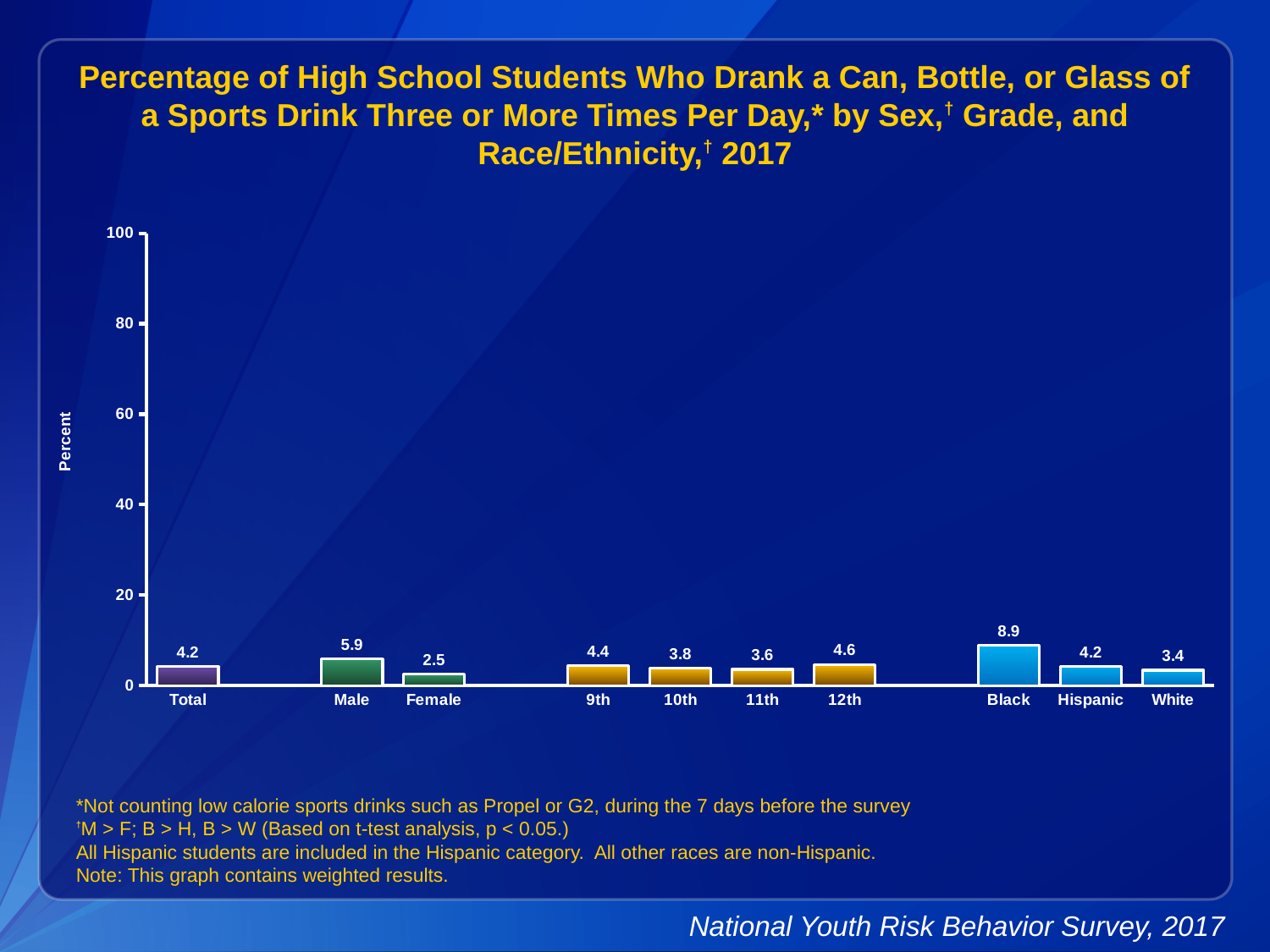
What kind of chart is this? bar chart Which category has the highest value? Black What is the difference between the values for Male and Female? 3.4 Which category has the lowest value? Female What is the value for Total? 4.2 What is the value for Female? 2.5 What is the value for Male? 5.9 Is the value for Black greater or less than 20? less Which is larger, the value for 9th or the value for 11th? 9th What is the label of the y axis? Percent How many categories are shown on the x axis? 10 What is the value for Black? 8.9